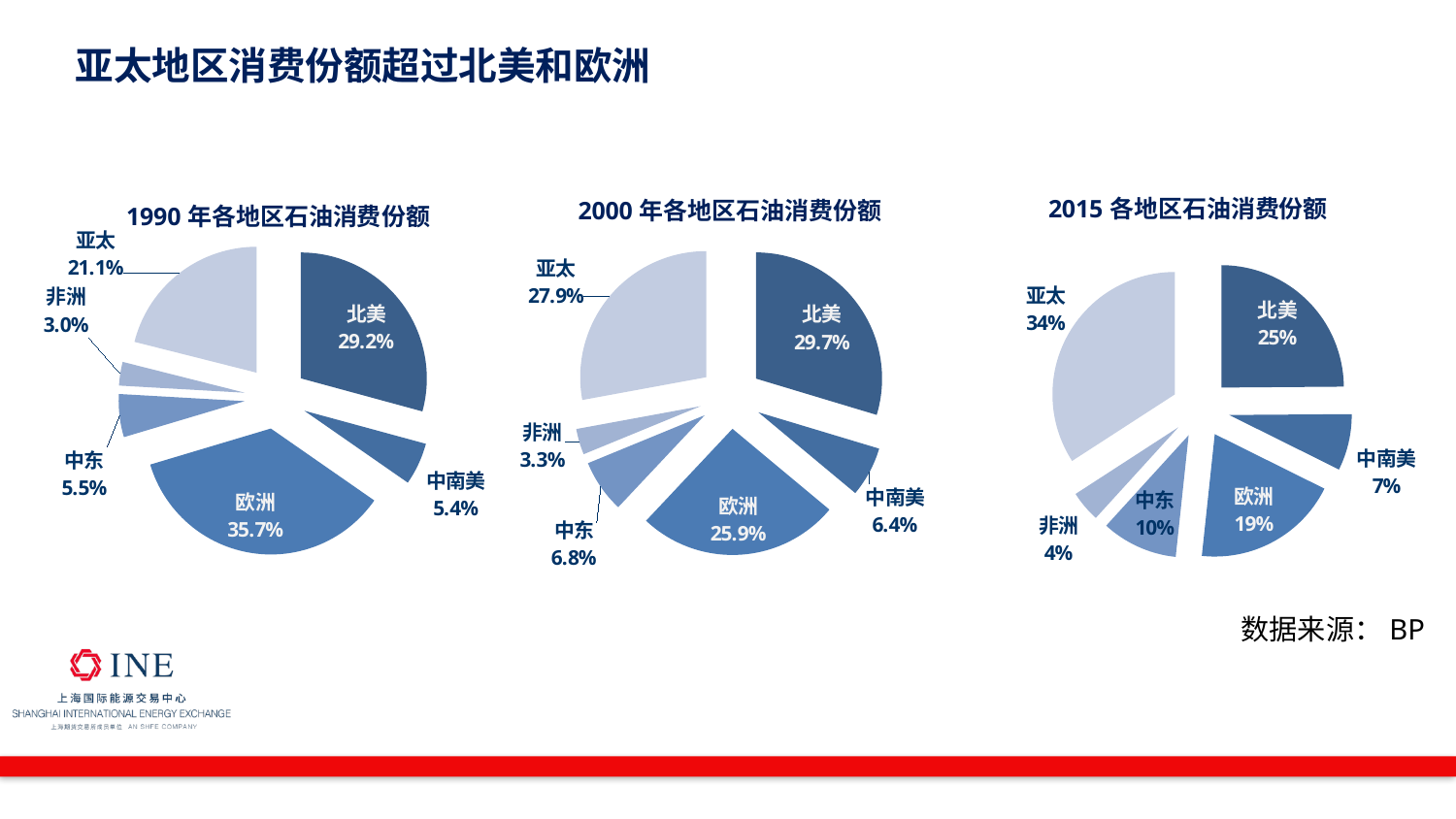
How many regions are shown in the 2015 各地区石油消费份额 chart? 6 In the 2015 各地区石油消费份额 chart, what is the difference between the shares of 亚太 and 北美? 9% In the 2015 各地区石油消费份额 chart, which region has the largest share? 亚太 In the 1990 年各地区石油消费份额 chart, what is the share for 欧洲? 35.7% In the 2015 各地区石油消费份额 chart, what is the share for 中东? 10% In the 2000 年各地区石油消费份额 chart, what is the difference between the shares of 北美 and 欧洲? 3.8% In the 2000 年各地区石油消费份额 chart, what is the share for 亚太? 27.9% In the 1990 年各地区石油消费份额 chart, which is larger, the share of 中东 or 中南美? 中东 How many pie charts are on the slide? 3 What type of chart is the 1990 年各地区石油消费份额 chart? Pie chart In the 2000 年各地区石油消费份额 chart, which region has the largest share? 北美 In the 1990 年各地区石油消费份额 chart, which region has the smallest share? 非洲